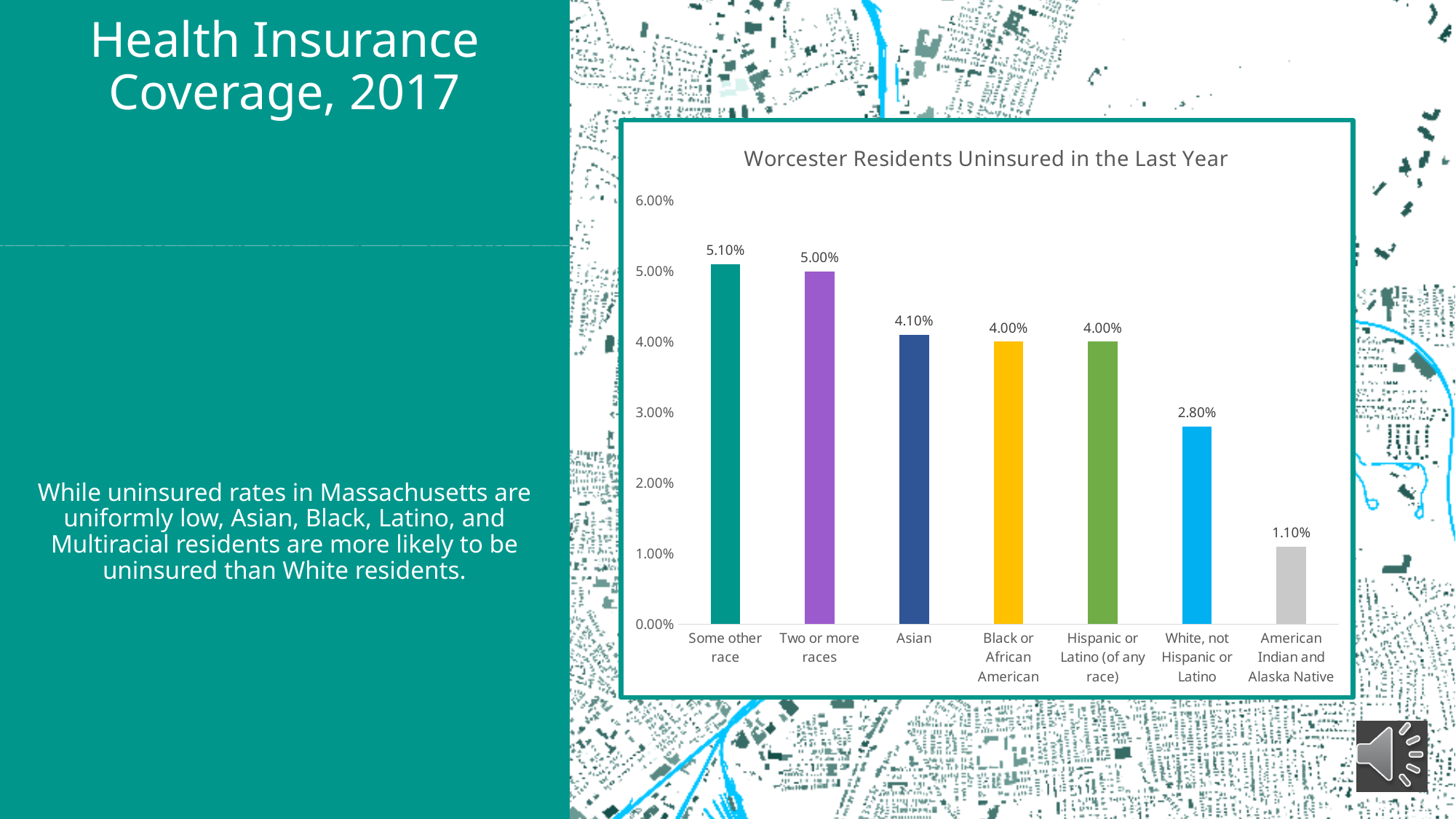
What is the difference between the uninsured rate for Some other race and for American Indian and Alaska Native? 4.00% What is the uninsured rate for Asian residents? 4.10% What is the title of the chart? Worcester Residents Uninsured in the Last Year What is the uninsured rate for American Indian and Alaska Native residents? 1.10% What kind of chart is shown on the slide? Bar chart What is the difference between the uninsured rate for Two or more races and for White, not Hispanic or Latino? 2.20% Which category has the lowest uninsured rate? American Indian and Alaska Native What is the uninsured rate for White, not Hispanic or Latino residents? 2.80% Which category has the highest uninsured rate? Some other race Which has a higher uninsured rate, Asian or Hispanic or Latino (of any race)? Asian How many categories are shown in the chart? 7 Is the value for Black or African American greater or less than 3.00%? greater